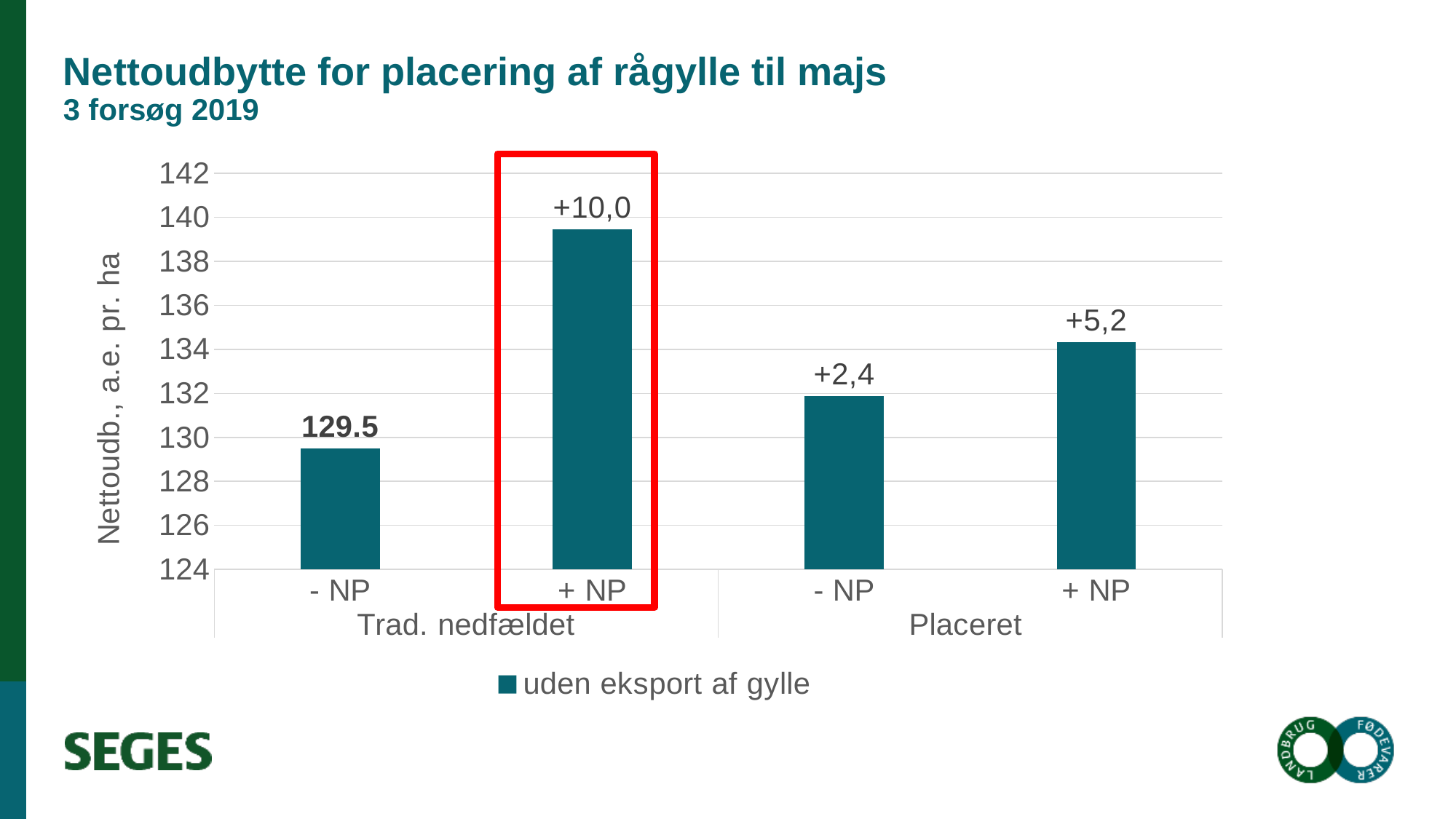
What data label is printed above the '+ NP' bar under 'Trad. nedfældet'? +10,0 What kind of chart is shown on the slide? bar chart How many bars are plotted in the chart? 4 Under 'Placeret', which bar is taller, '- NP' or '+ NP'? + NP What is the legend entry shown below the chart? uden eksport af gylle What data label is printed above the '- NP' bar under 'Placeret'? +2,4 Is the value of the '+ NP' bar under 'Trad. nedfældet' greater or less than 140? less How many series does the legend list? 1 What data label is printed above the '- NP' bar under 'Trad. nedfældet'? 129.5 Which bar is the shortest in the chart? - NP under Trad. nedfældet What data label is printed above the '+ NP' bar under 'Placeret'? +5,2 Which bar is the tallest in the chart? + NP under Trad. nedfældet